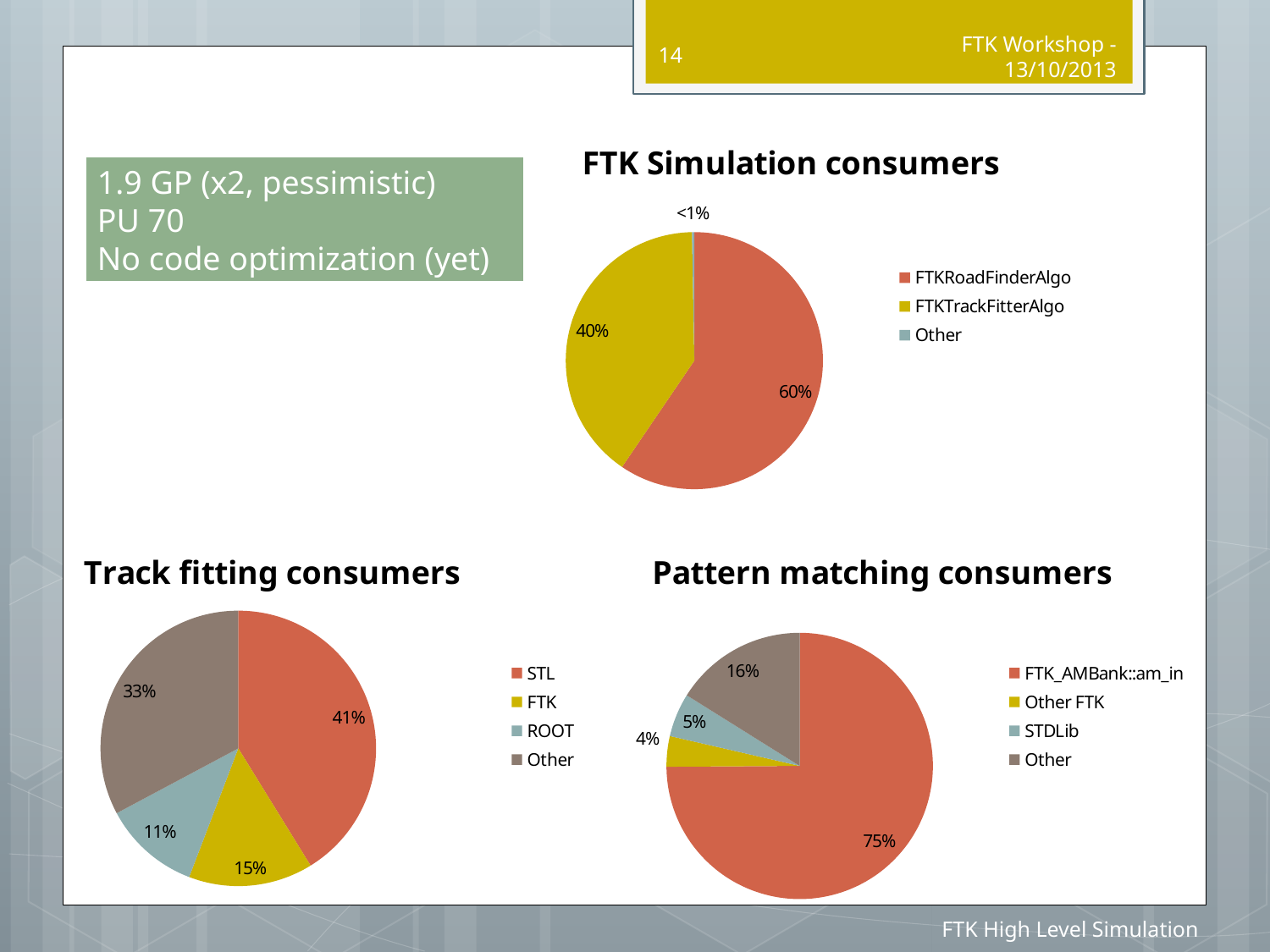
In the 'FTK Simulation consumers' chart, what share does FTKRoadFinderAlgo have? 60% In the 'Pattern matching consumers' chart, which is larger, STDLib or Other FTK? STDLib In the 'FTK Simulation consumers' chart, what share does FTKTrackFitterAlgo have? 40% In the 'Track fitting consumers' chart, how many slices does the pie have? 4 In the 'Pattern matching consumers' chart, what share does Other have? 16% In the 'FTK Simulation consumers' chart, what is the label shown for the Other slice? <1% In the 'Track fitting consumers' chart, which category has the smallest share? ROOT What type of chart is 'Pattern matching consumers'? Pie chart In the 'Track fitting consumers' chart, what is the difference between the Other share and the FTK share? 18% In the 'FTK Simulation consumers' chart, how many entries does the legend list? 3